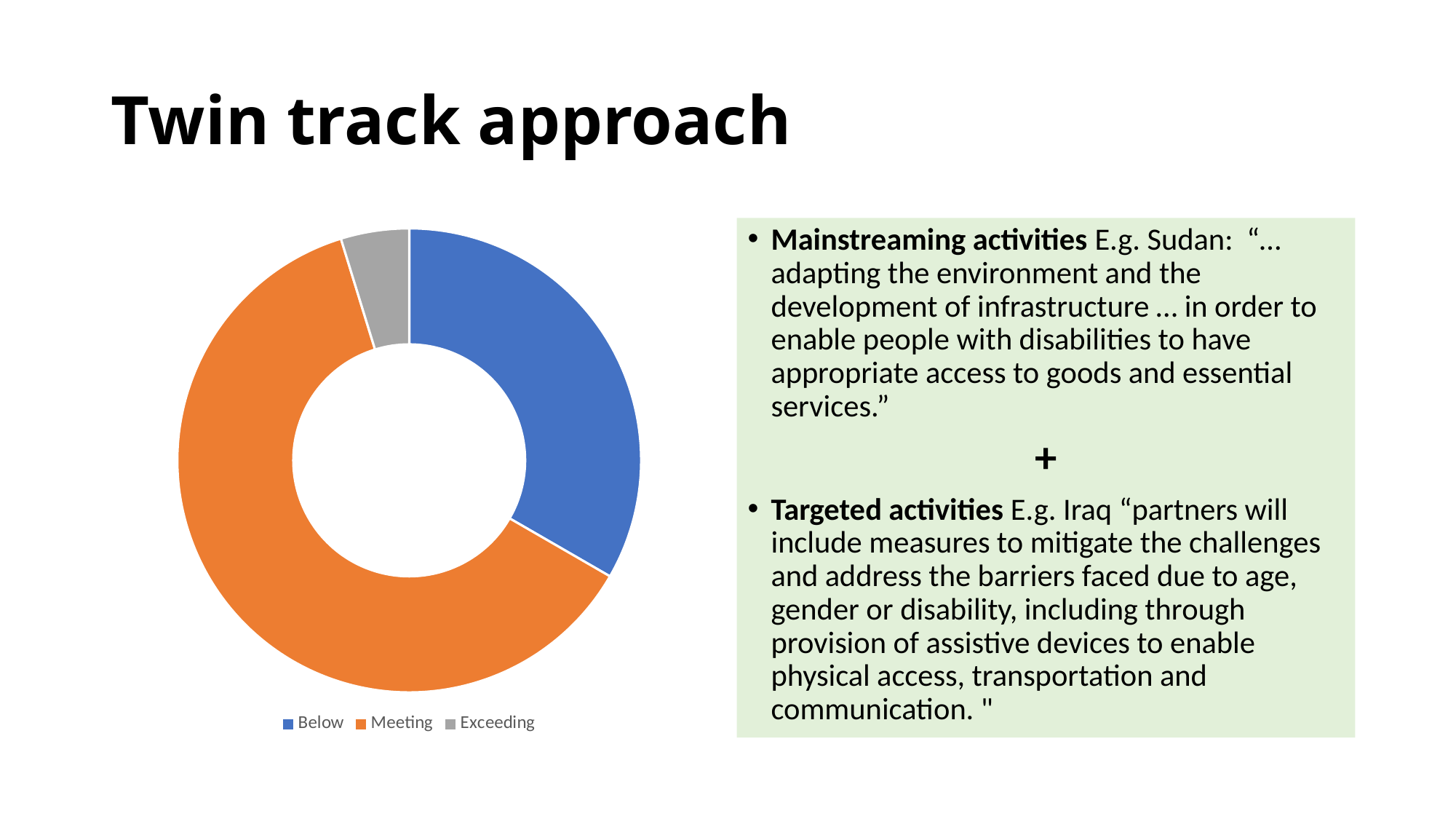
What colour represents the Meeting category in the doughnut chart? Orange Which category takes up the smallest share of the doughnut chart? Exceeding Which category is shown in grey in the doughnut chart? Exceeding Which category has the larger share of the doughnut chart, Below or Exceeding? Below Which category has the smaller share of the doughnut chart, Meeting or Exceeding? Exceeding Which category has the larger share of the doughnut chart, Meeting or Below? Meeting Which category takes up the largest share of the doughnut chart? Meeting How many categories does the doughnut chart show? 3 What kind of chart is shown on the slide? Doughnut chart